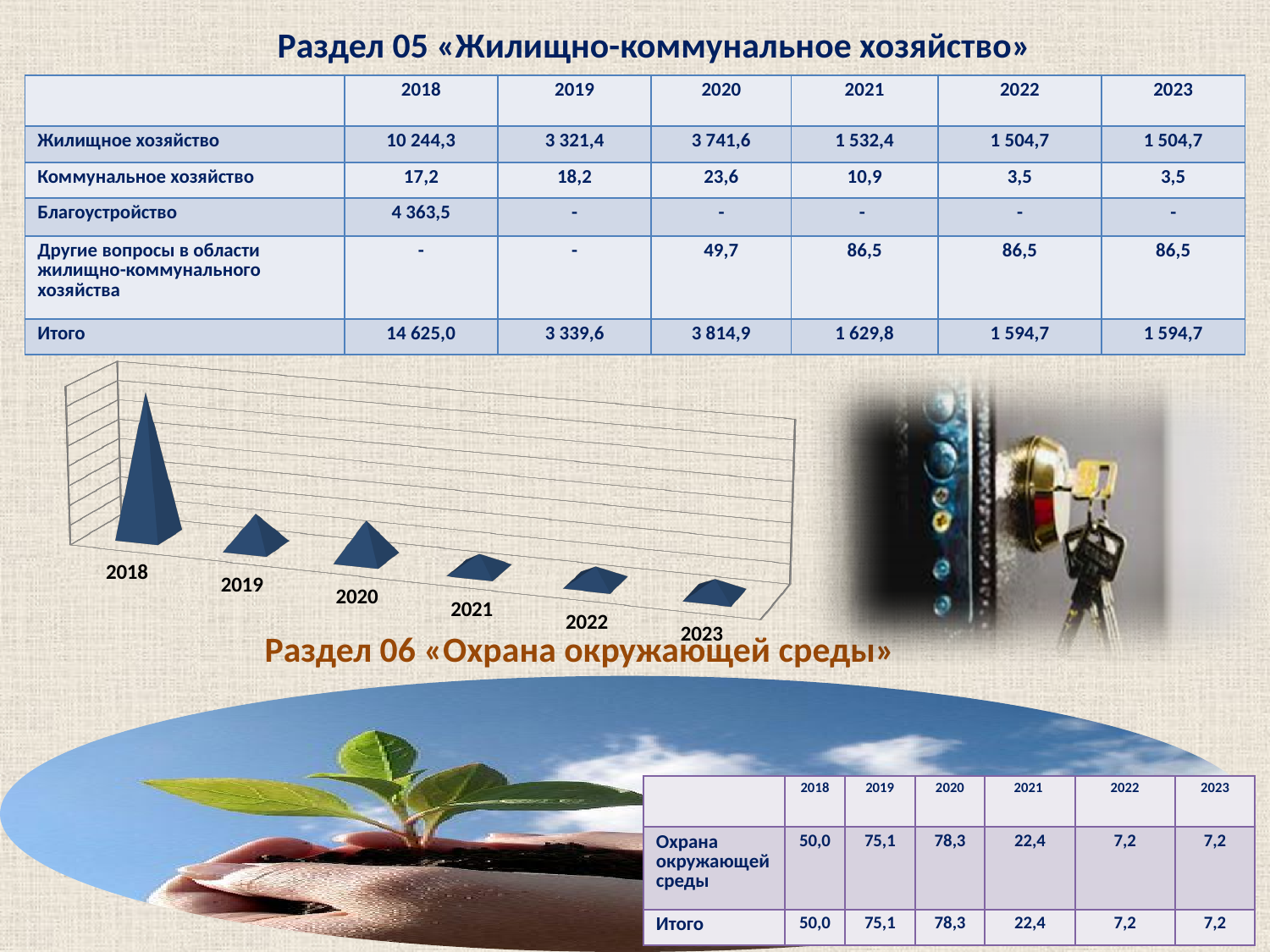
Is the bar for 2018 larger or smaller than the bar for 2019? larger What is the first category label on the chart's x axis? 2018 Do the values in the chart generally rise or fall from 2018 to 2023? fall What is the last category label on the chart's x axis? 2023 What kind of chart is shown on the slide? bar chart Which is larger in the chart, the bar for 2018 or the bar for 2023? 2018 Which year has the tallest bar in the chart? 2018 How many categories (years) are shown on the chart's x axis? 6 Which is larger in the chart, the bar for 2020 or the bar for 2021? 2020